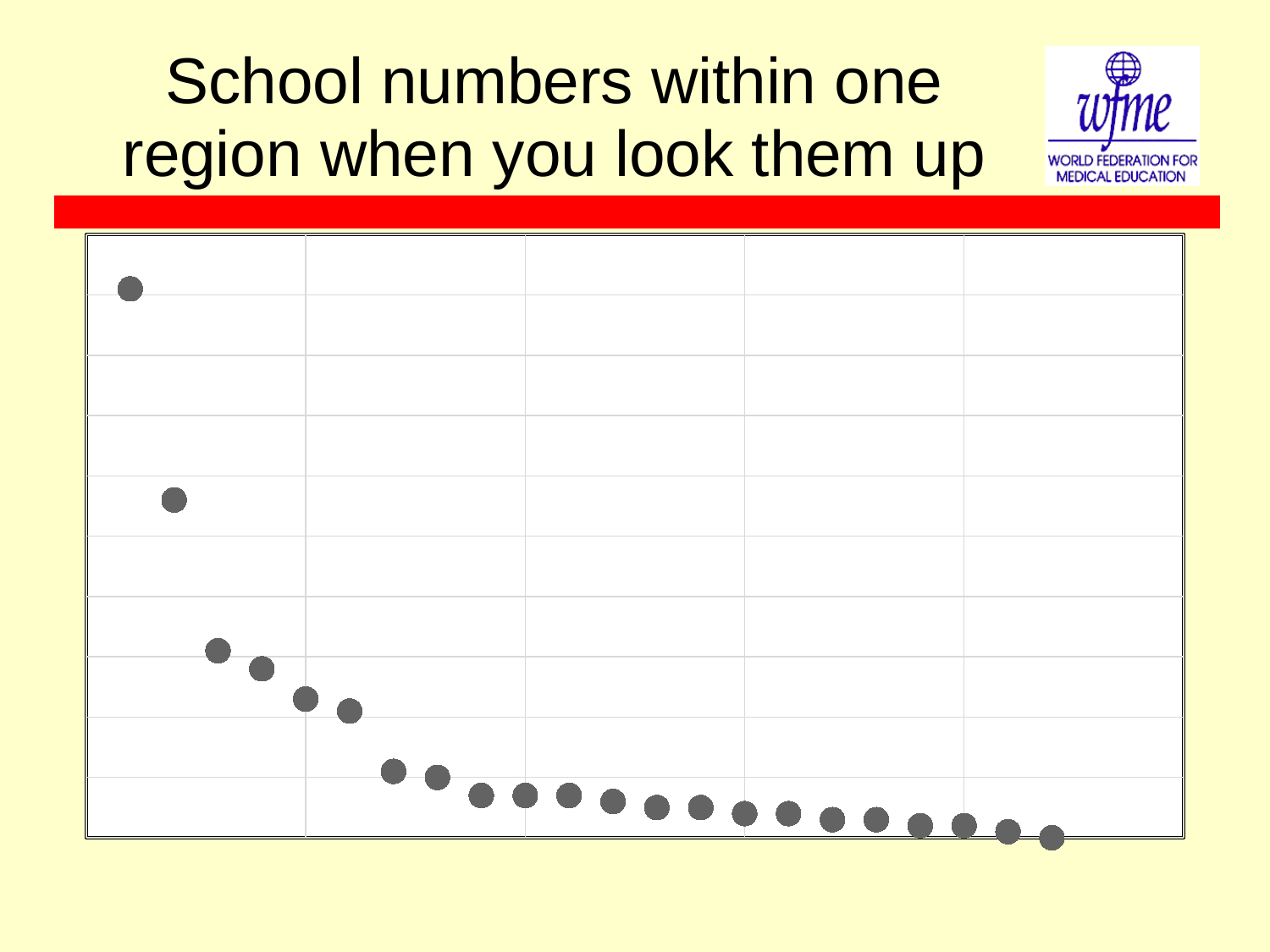
Is the first (leftmost) point higher or lower than the second point? Higher What is the title of the slide containing the chart? School numbers within one region when you look them up Which point on the chart has the lowest value, the leftmost or the rightmost? The rightmost Do the plotted values rise or fall from left to right along the x axis? Fall Does the chart display a legend? No How many data points are plotted on the chart? 22 What kind of chart is shown on the slide? Scatter chart Which point on the chart has the highest value, the leftmost or the rightmost? The leftmost